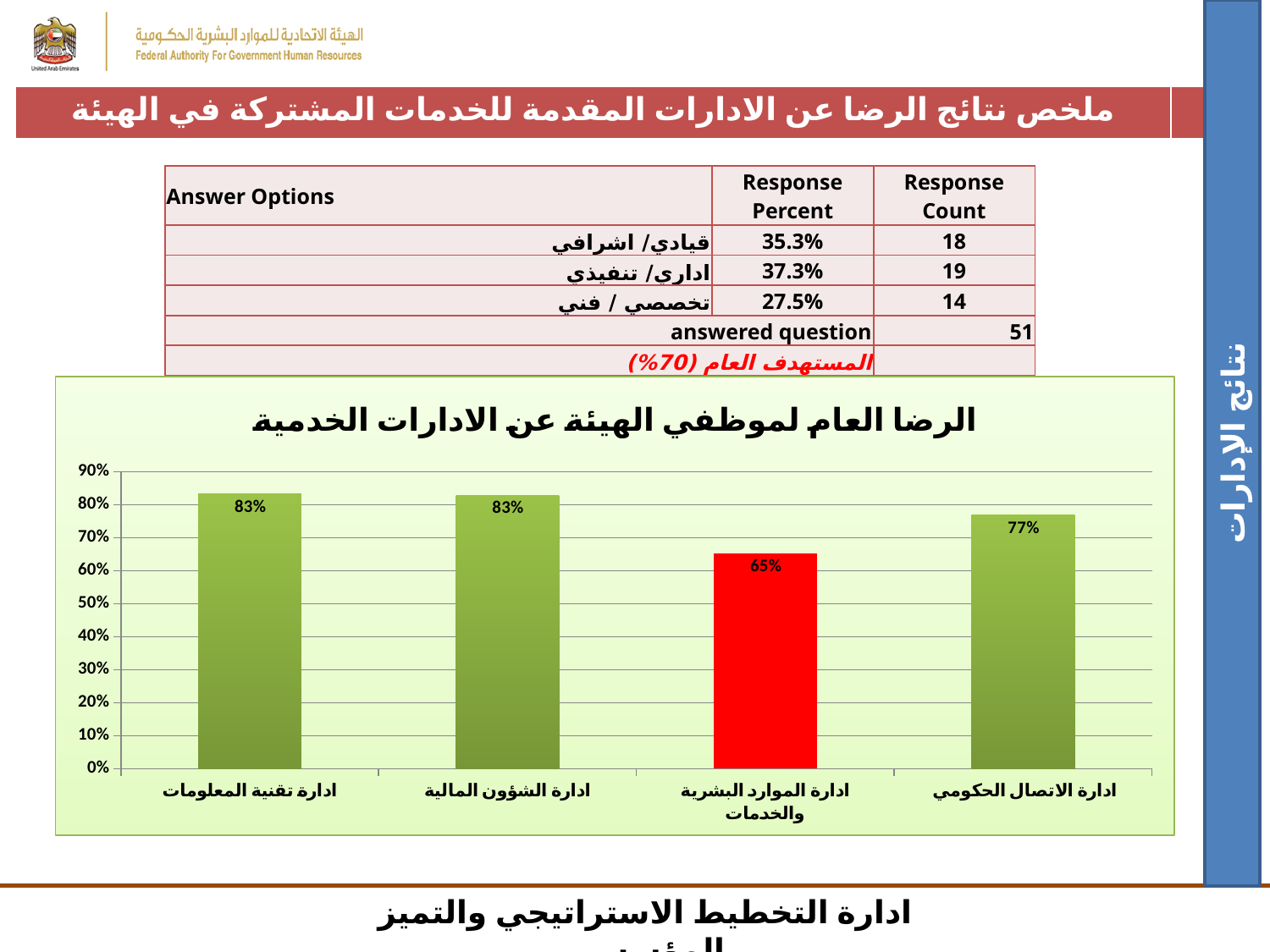
Which is larger, the value for ادارة الشؤون المالية or the value for ادارة الاتصال الحكومي? ادارة الشؤون المالية What is the value for ادارة تقنية المعلومات? 83% What is the difference between the values for ادارة الاتصال الحكومي and ادارة الموارد البشرية والخدمات? 12% Which department has the lowest value in the chart? ادارة الموارد البشرية والخدمات Which bar in the chart is coloured red rather than green? ادارة الموارد البشرية والخدمات What is the value for ادارة الاتصال الحكومي? 77% What is the value for ادارة الشؤون المالية? 83% What is the title of the chart? الرضا العام لموظفي الهيئة عن الادارات الخدمية What type of chart is shown on the slide? bar chart How many departments (categories) are plotted in the chart? 4 Is the value for ادارة الموارد البشرية والخدمات greater or less than 70%? less What is the value for ادارة الموارد البشرية والخدمات? 65%